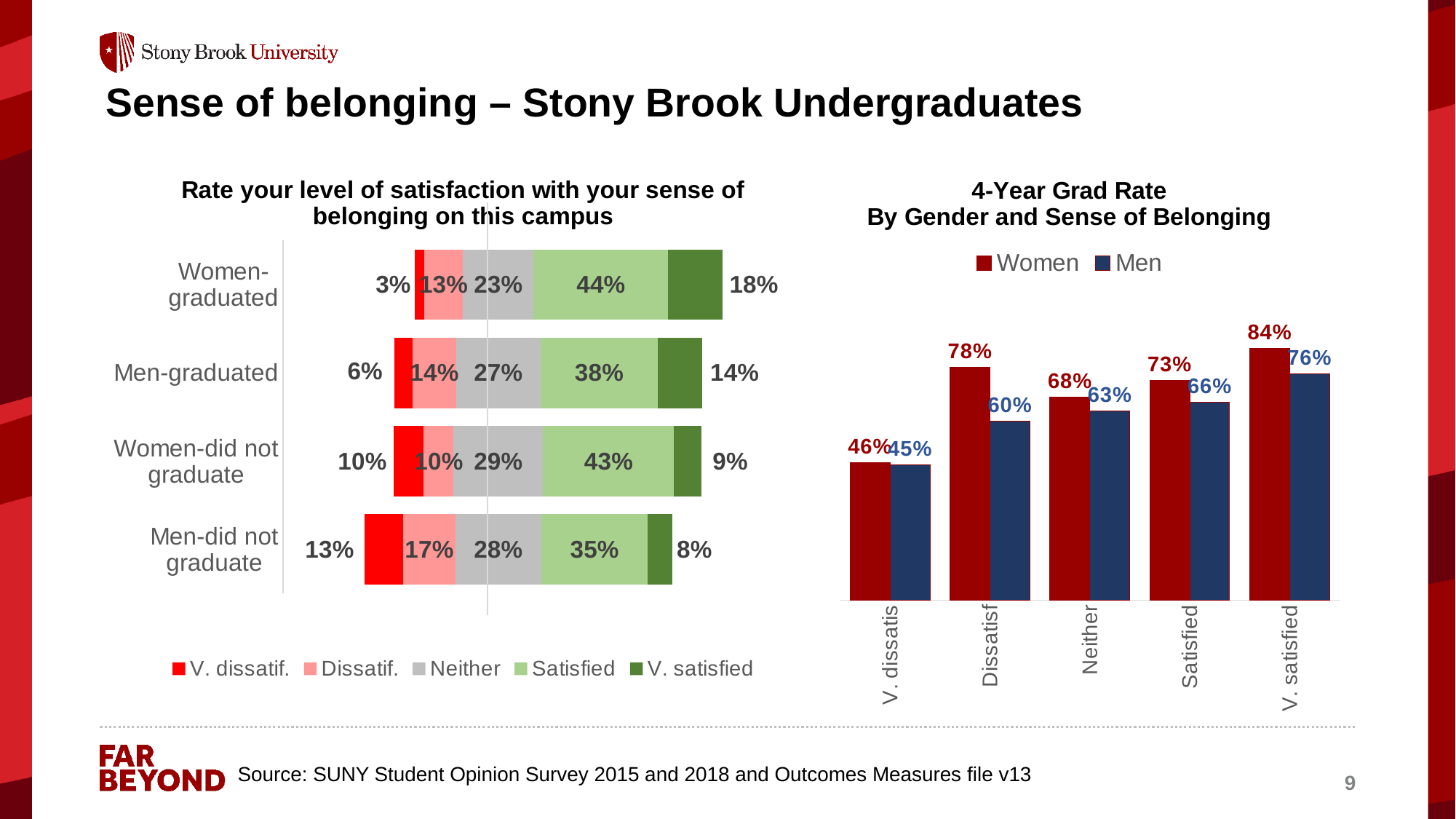
How many groups (categories) are shown in the 'Rate your level of satisfaction with your sense of belonging on this campus' chart? 4 In the '4-Year Grad Rate By Gender and Sense of Belonging' chart, which category has the lowest grad rate for women? V. dissatis How many series does the legend of the '4-Year Grad Rate By Gender and Sense of Belonging' chart list? 2 In the '4-Year Grad Rate By Gender and Sense of Belonging' chart, which category has the highest grad rate for men? V. satisfied In the 'Rate your level of satisfaction with your sense of belonging on this campus' chart, which group has the highest 'V. satisfied' percentage? Women-graduated In the '4-Year Grad Rate By Gender and Sense of Belonging' chart, which is larger: the women's grad rate for 'Neither' or the men's grad rate for 'Satisfied'? Women's grad rate for 'Neither' (68%) In the '4-Year Grad Rate By Gender and Sense of Belonging' chart, what is the 4-year grad rate for men who are 'Dissatisf'? 60% In the '4-Year Grad Rate By Gender and Sense of Belonging' chart, what is the difference between the women's and men's grad rates in the 'Dissatisf' category? 18% In the '4-Year Grad Rate By Gender and Sense of Belonging' chart, what is the 4-year grad rate for women who are 'V. satisfied'? 84% In the 'Rate your level of satisfaction with your sense of belonging on this campus' chart, what percentage of 'Women-graduated' are 'Satisfied'? 44% In the 'Rate your level of satisfaction with your sense of belonging on this campus' chart, what percentage of 'Men-did not graduate' are 'V. dissatif.'? 13% What type of chart is the 'Rate your level of satisfaction with your sense of belonging on this campus' chart? Stacked bar chart